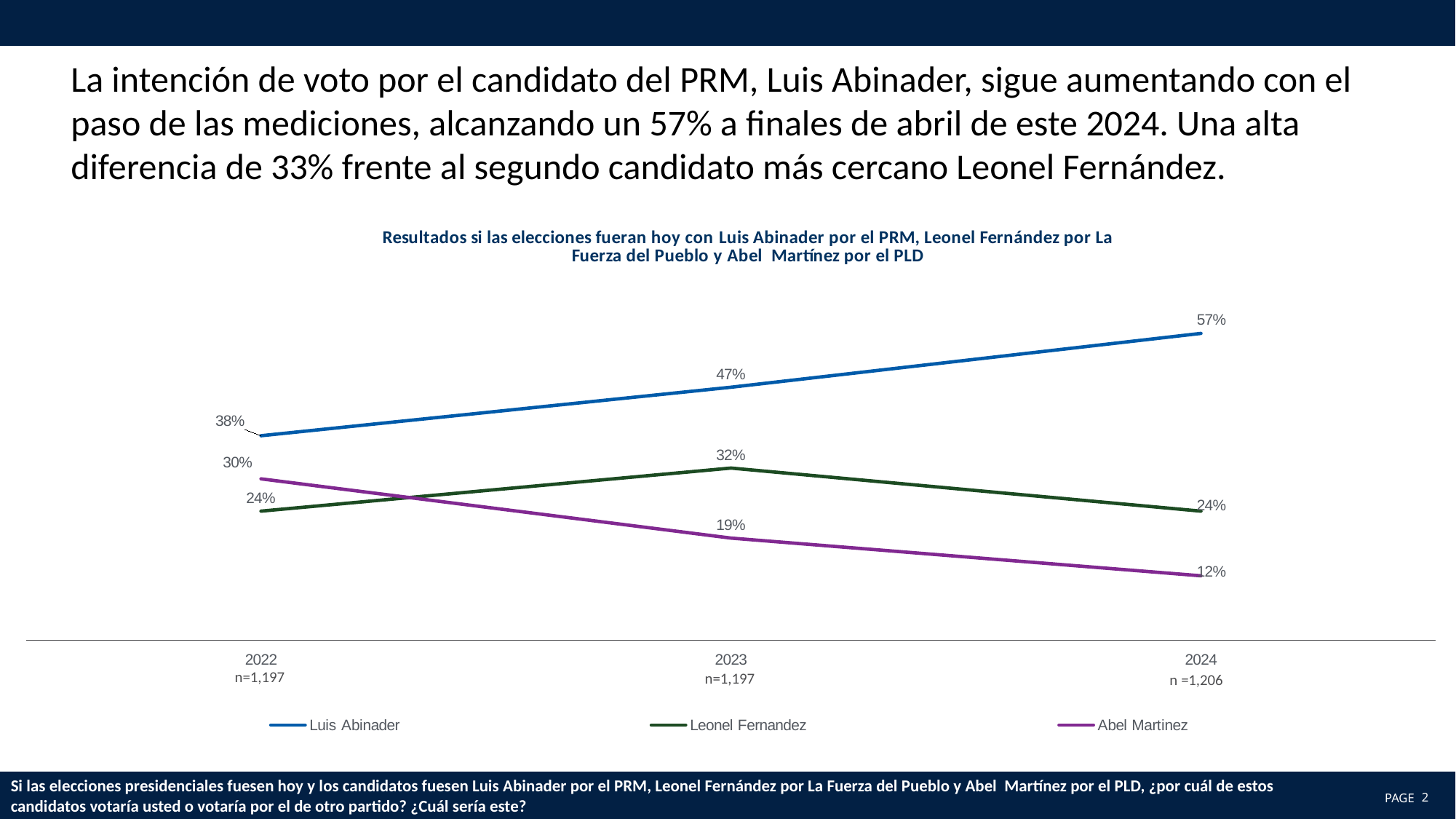
Does the value for Abel Martinez rise or fall from 2022 to 2024? fall What type of chart is shown on the slide? line chart Which candidate has the lowest value in 2024? Abel Martinez What is the value for Luis Abinader in 2024? 57% What is the value for Luis Abinader in 2022? 38% How many series does the legend list? 3 How many years are shown on the x axis? 3 What is the difference between Luis Abinader and Leonel Fernandez in 2024? 33% What is the value for Leonel Fernandez in 2023? 32% What is the value for Abel Martinez in 2022? 30% In 2022, which is larger: the value for Abel Martinez or the value for Leonel Fernandez? Abel Martinez Which candidate has the highest value in 2024? Luis Abinader